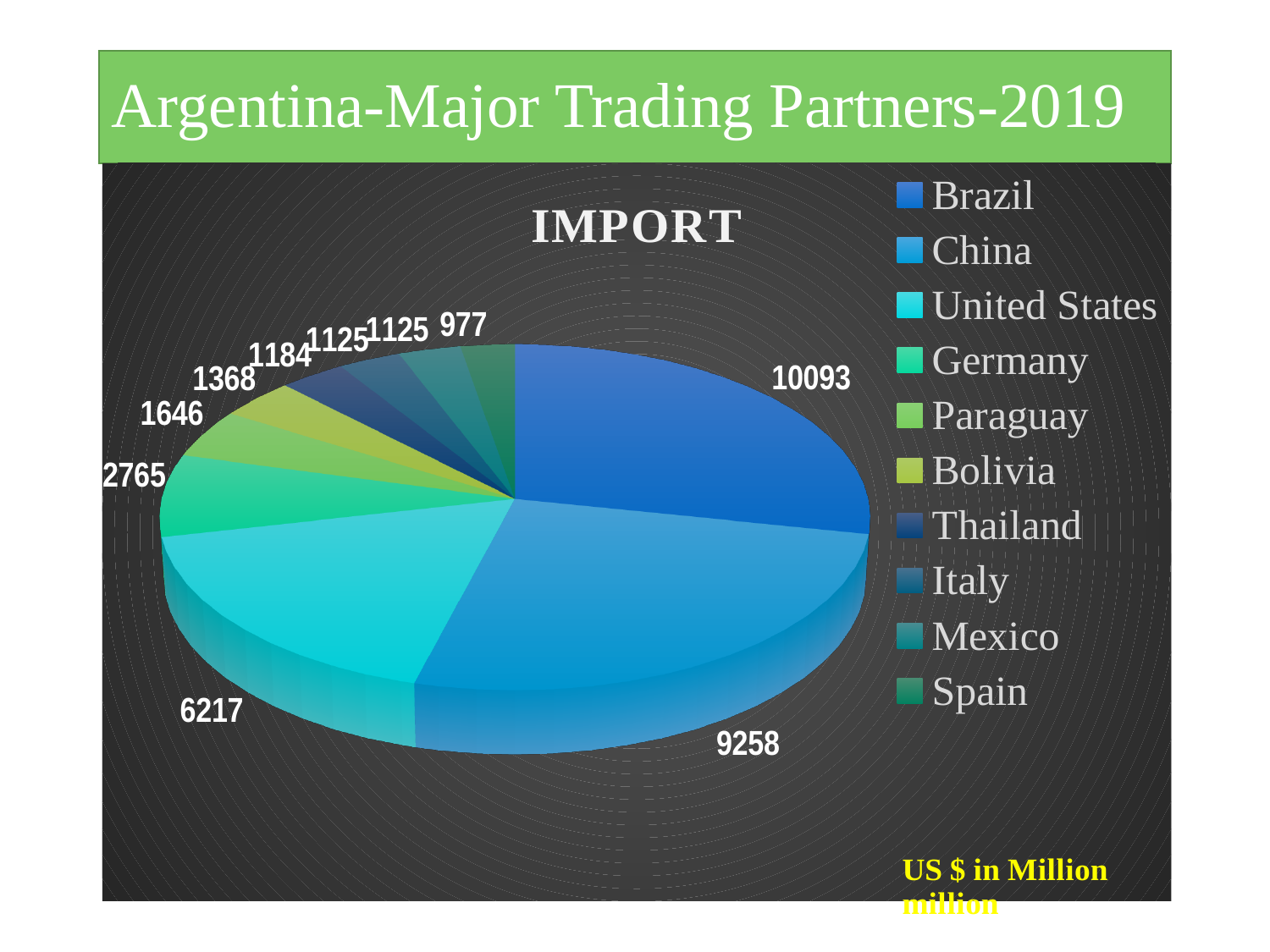
What is the import value for Brazil? 10093 What is the import value for Spain? 977 Which trading partner has the smallest import value? Spain How many trading partners are shown in the pie chart? 10 In what units are the values on the chart expressed? US $ in Million Which trading partner has the largest import value? Brazil Which has a larger import value, United States or Germany? United States What is the title of the chart? IMPORT What is the difference between the import values for Brazil and China? 835 What is the import value for China? 9258 What is the import value for Germany? 2765 What kind of chart is shown on the slide? Pie chart